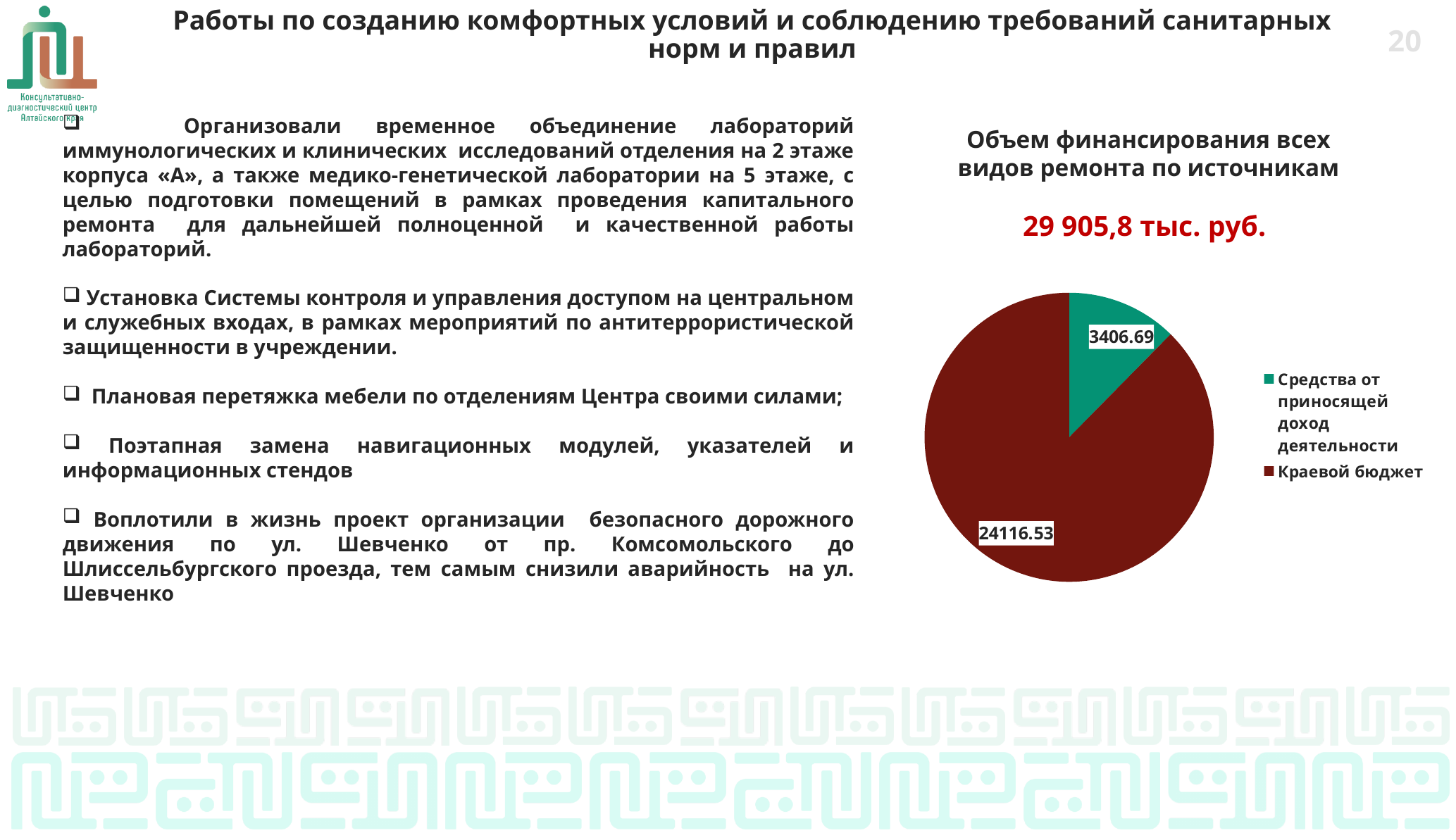
What is the difference between the Краевой бюджет value and the Средства от приносящей доход деятельности value in the pie chart? 20709.84 What value is shown for the Краевой бюджет slice of the pie chart? 24116.53 Which source has the smallest slice in the pie chart? Средства от приносящей доход деятельности What value is shown for the Средства от приносящей доход деятельности slice of the pie chart? 3406.69 Which source has the largest slice in the pie chart? Краевой бюджет How many entries does the legend of the pie chart list? 2 What is the title of the chart on the slide? Объем финансирования всех видов ремонта по источникам What colour is the Краевой бюджет slice in the pie chart? Dark red What kind of chart is shown on the slide? Pie chart How many slices does the pie chart have? 2 Which is larger in the pie chart: Краевой бюджет or Средства от приносящей доход деятельности? Краевой бюджет